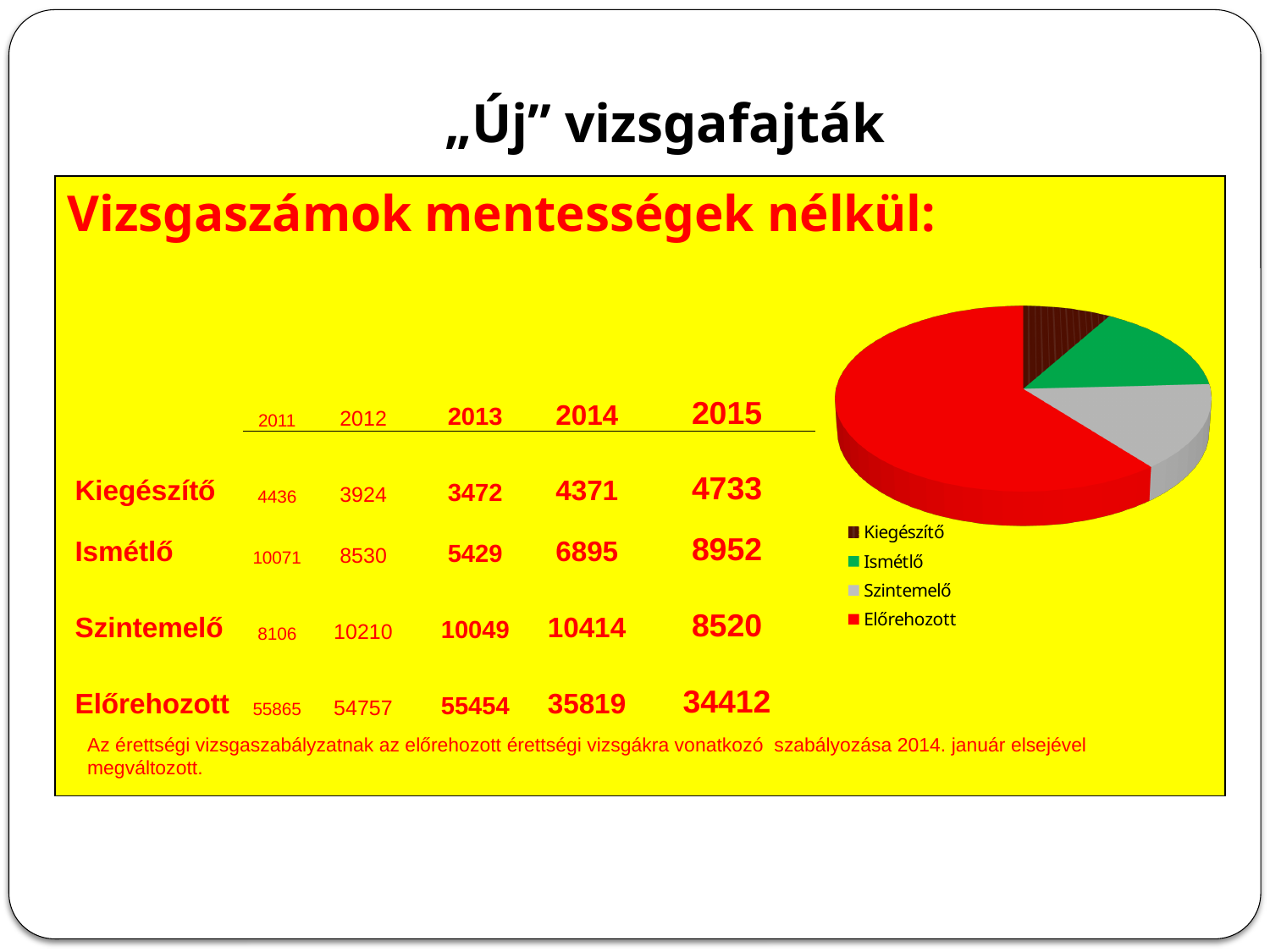
What colour is the Előrehozott slice in the pie chart? red In the pie chart, which slice is larger: Kiegészítő or Ismétlő? Ismétlő Which category has the smallest slice in the pie chart? Kiegészítő Which category is shown in green in the pie chart? Ismétlő How many categories does the pie chart's legend list? 4 Which category has the largest slice in the pie chart? Előrehozott In the pie chart, which slice is larger: Előrehozott or Ismétlő? Előrehozott In the pie chart, which slice is larger: Előrehozott or Szintemelő? Előrehozott What kind of chart is shown on the slide? pie chart